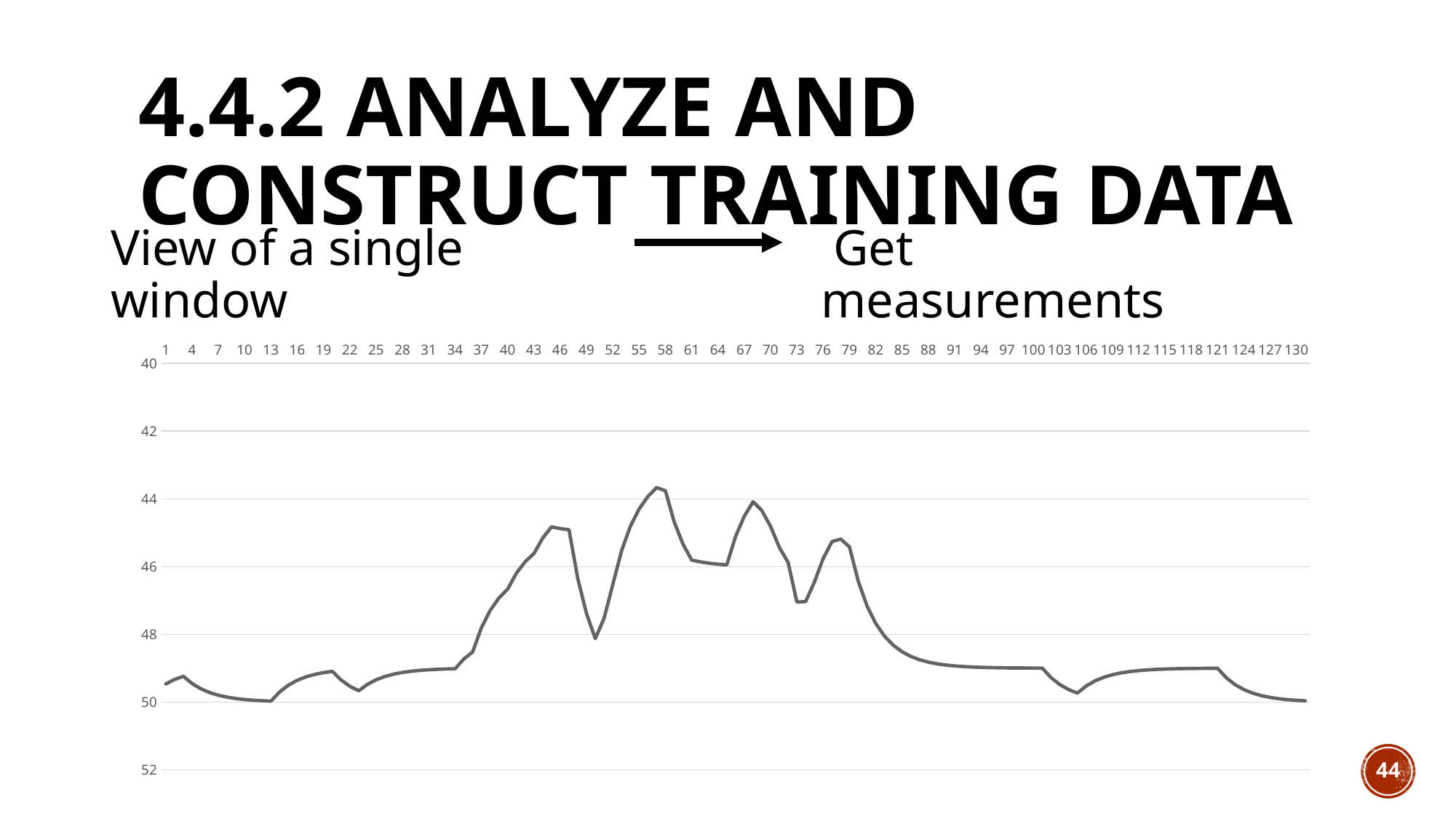
What is the last label on the horizontal axis? 130 What kind of chart is shown on the slide? line chart Is the value at x = 115 greater or less than 50? less Is the value at x = 58 greater or less than 44? less Is the value at x = 67 greater or less than 46? less How many labels are printed along the horizontal axis? 44 What is the highest value shown on the vertical axis? 52